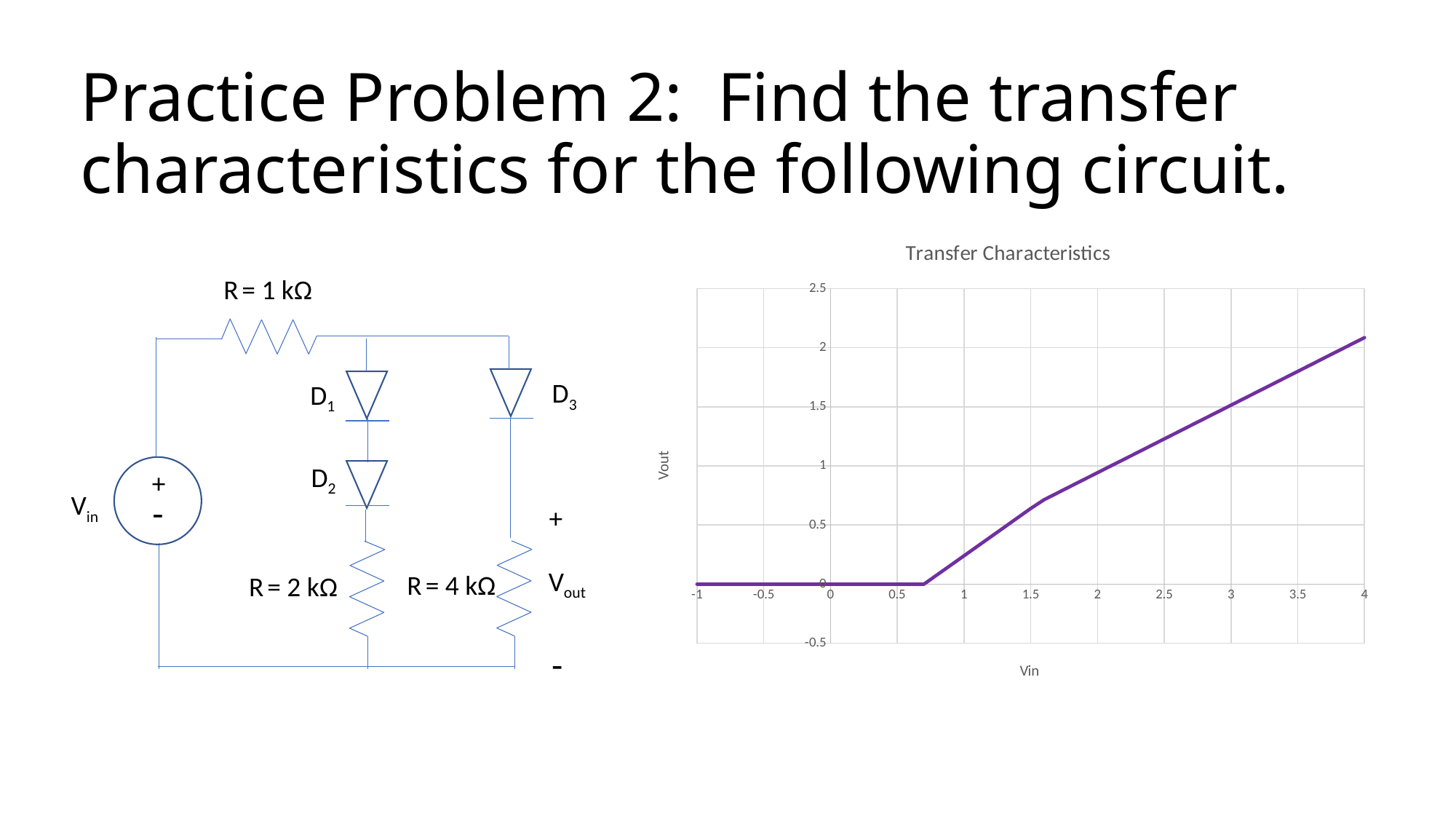
Is the value of Vout at Vin = 1 greater or less than 0.5? less What is the title of the chart on the slide? Transfer Characteristics What kind of chart is shown on the slide? line chart Does Vout rise or fall as Vin increases from 1 to 4 on the chart? rise Is the value of Vout at Vin = 0 greater or less than 0.5? less Is the value of Vout at Vin = -0.5 greater or less than 0.5? less What is the label of the horizontal axis of the chart? Vin What is the highest value shown on the vertical axis of the chart? 2.5 How many tick marks are labelled on the horizontal axis of the chart? 11 Which has the larger Vout on the chart: Vin = 1 or Vin = 3? Vin = 3